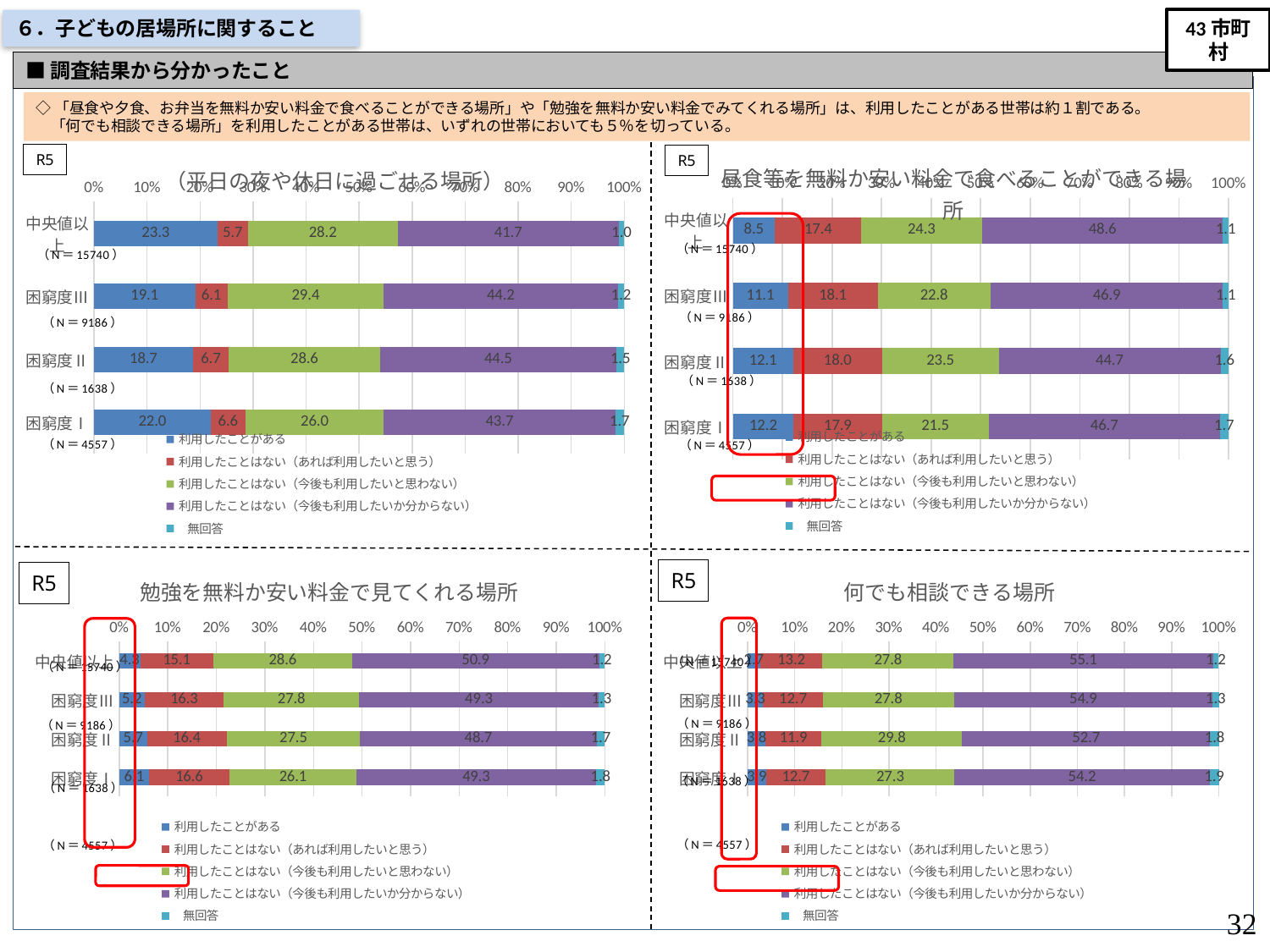
How many series does the legend of the top-left chart (平日の夜や休日に過ごせる場所) list? 5 What type of chart is the top-right chart (昼食等を無料か安い料金で食べることができる場所)? Stacked bar chart In the bottom-left chart (勉強を無料か安い料金で見てくれる場所), which category has the highest value for 利用したことがある? 困窮度I In the top-right chart (昼食等を無料か安い料金で食べることができる場所), what is the value of 利用したことがある for 困窮度I? 12.2 How many categories are shown in the bottom-left chart (勉強を無料か安い料金で見てくれる場所)? 4 In the bottom-left chart (勉強を無料か安い料金で見てくれる場所), what is the value of 利用したことはない（今後も利用したいか分からない） for 中央値以上? 50.9 In the bottom-right chart (何でも相談できる場所), what is the value of 利用したことはない（今後も利用したいか分からない） for 中央値以上? 55.1 In the bottom-right chart (何でも相談できる場所), which is larger for 困窮度II: 利用したことはない（あれば利用したいと思う） or 利用したことはない（今後も利用したいと思わない）? 利用したことはない（今後も利用したいと思わない） In the top-left chart (平日の夜や休日に過ごせる場所), what is the value of 利用したことはない（今後も利用したいか分からない） for 困窮度II? 44.5 In the top-right chart (昼食等を無料か安い料金で食べることができる場所), what is the difference between the 利用したことがある values for 困窮度I and 中央値以上? 3.7 In the top-right chart (昼食等を無料か安い料金で食べることができる場所), which category has the lowest value for 利用したことがある? 中央値以上 In the top-left chart (平日の夜や休日に過ごせる場所), what is the value of 利用したことがある for 中央値以上? 23.3